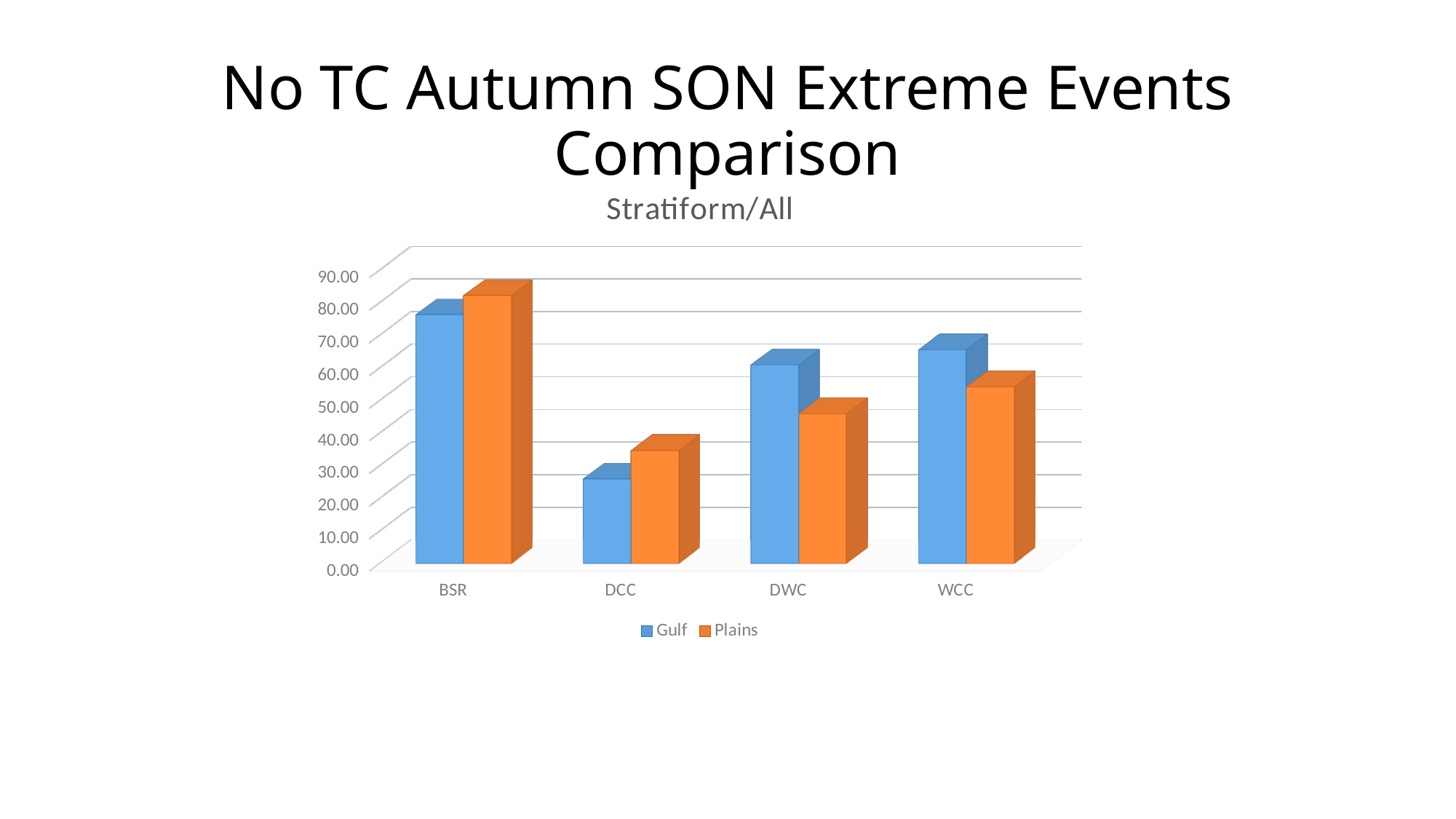
For DCC, which series has the larger value, Gulf or Plains? Plains How many categories are shown on the x axis of the chart? 4 Which category has the lowest Gulf value? DCC Is the Gulf value for WCC greater or less than 60.00? greater Is the Plains value for DCC greater or less than 40.00? less Is the Gulf value for BSR greater or less than 70.00? greater What kind of chart is shown on the slide? bar chart How many series does the legend list? 2 Which category has the lowest Plains value? DCC Which category has the highest Gulf value? BSR For DWC, which series has the larger value, Gulf or Plains? Gulf What is the title of the chart? Stratiform/All